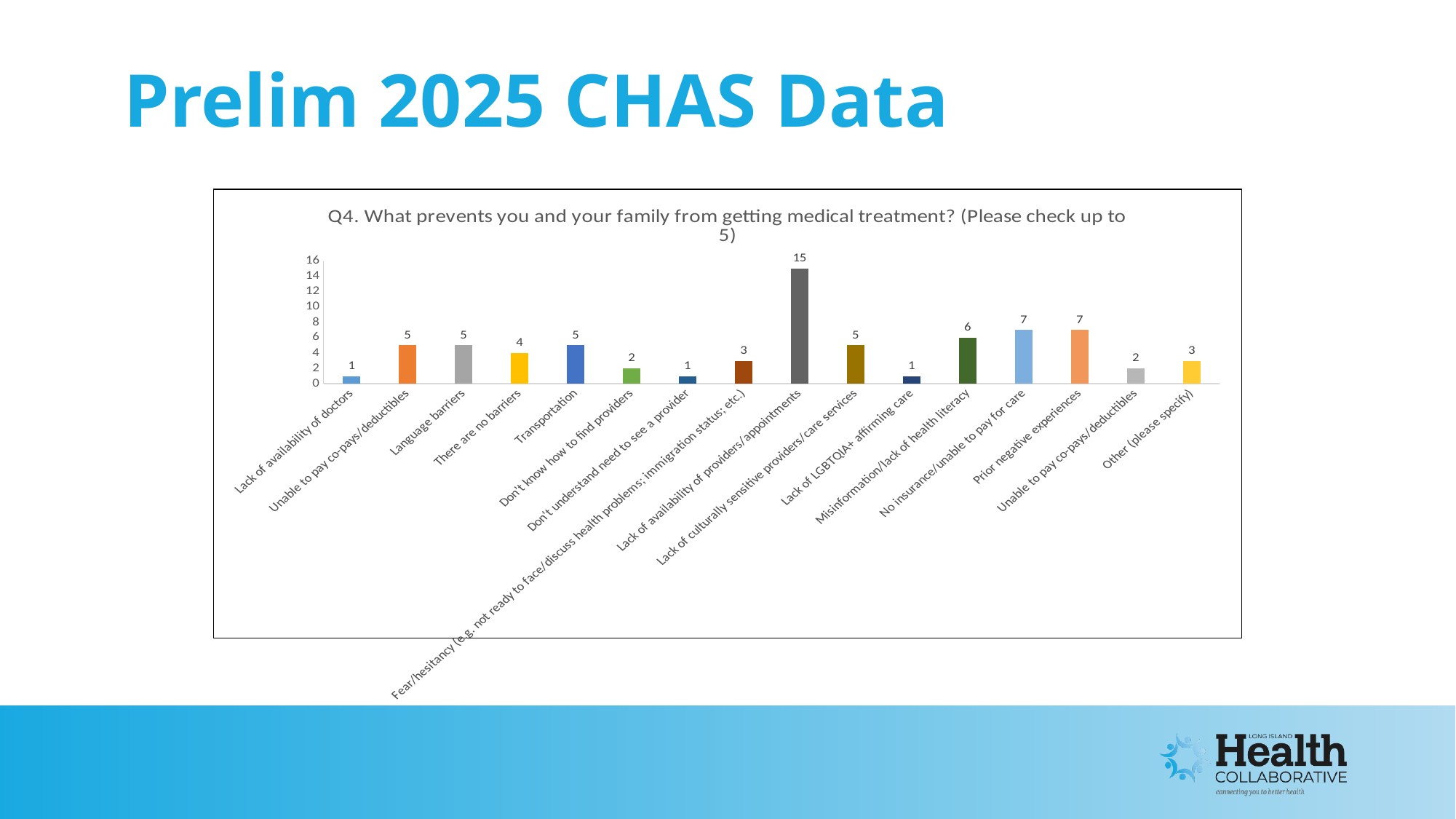
What is the value for Prior negative experiences? 7 What is the value for Misinformation/lack of health literacy? 6 How many categories are plotted in the chart? 16 What is the value for There are no barriers? 4 What kind of chart is shown on the slide? bar chart What is the title of the chart? Q4. What prevents you and your family from getting medical treatment? (Please check up to 5) What is the value for Transportation? 5 Which category has the highest value? Lack of availability of providers/appointments Which is larger, the value for No insurance/unable to pay for care or the value for There are no barriers? No insurance/unable to pay for care What is the value for Lack of LGBTQIA+ affirming care? 1 What is the difference between the value for Lack of availability of providers/appointments and the value for No insurance/unable to pay for care? 8 Is the value for Lack of availability of providers/appointments greater or less than 10? greater